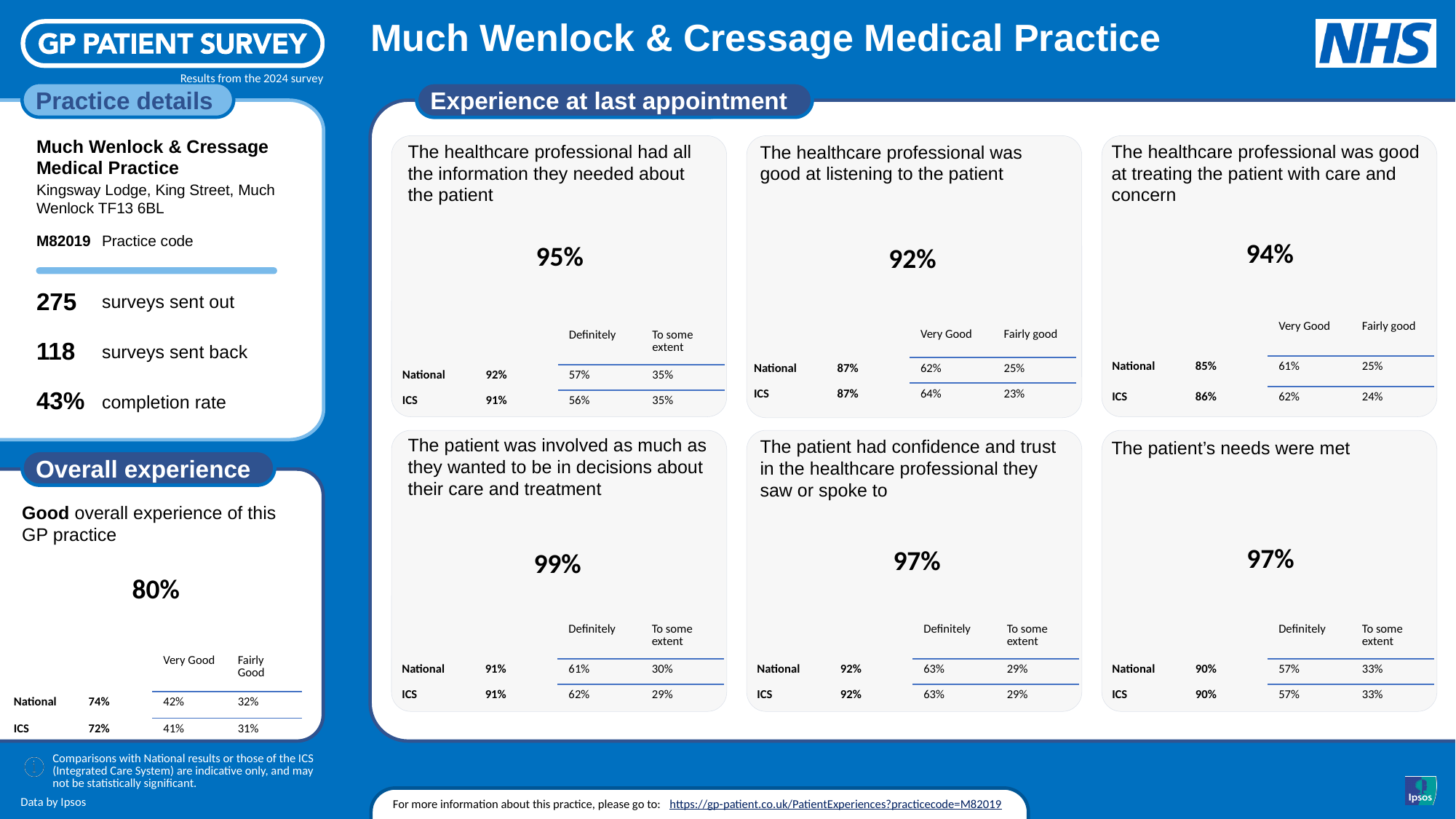
Which panel in the 'Experience at last appointment' section has the highest headline percentage? The patient was involved as much as they wanted to be in decisions about their care and treatment In the 'The healthcare professional was good at treating the patient with care and concern' panel, what is the National percentage? 85% How many panels are shown in the 'Experience at last appointment' section? 6 In the 'Good overall experience of this GP practice' panel, what is the National percentage? 74% In the 'The patient had confidence and trust in the healthcare professional they saw or spoke to' panel, is the practice's headline percentage or the National percentage larger? The practice's headline percentage In the 'Good overall experience of this GP practice' panel, what is the ICS 'Very Good' percentage? 41% In the 'The healthcare professional was good at listening to the patient' panel, what is the ICS 'Very Good' percentage? 64% Which panel in the 'Experience at last appointment' section has the lowest headline percentage? The healthcare professional was good at listening to the patient In the 'The healthcare professional had all the information they needed about the patient' panel, what is the practice's headline percentage? 95% In the 'The patient's needs were met' panel, what is the difference in percentage points between the practice's 97% and the ICS 90%? 7 In the 'Good overall experience of this GP practice' panel, what is the practice's headline percentage? 80% In the 'Good overall experience of this GP practice' panel, how many percentage points higher is the practice's 80% than the National 74%? 6